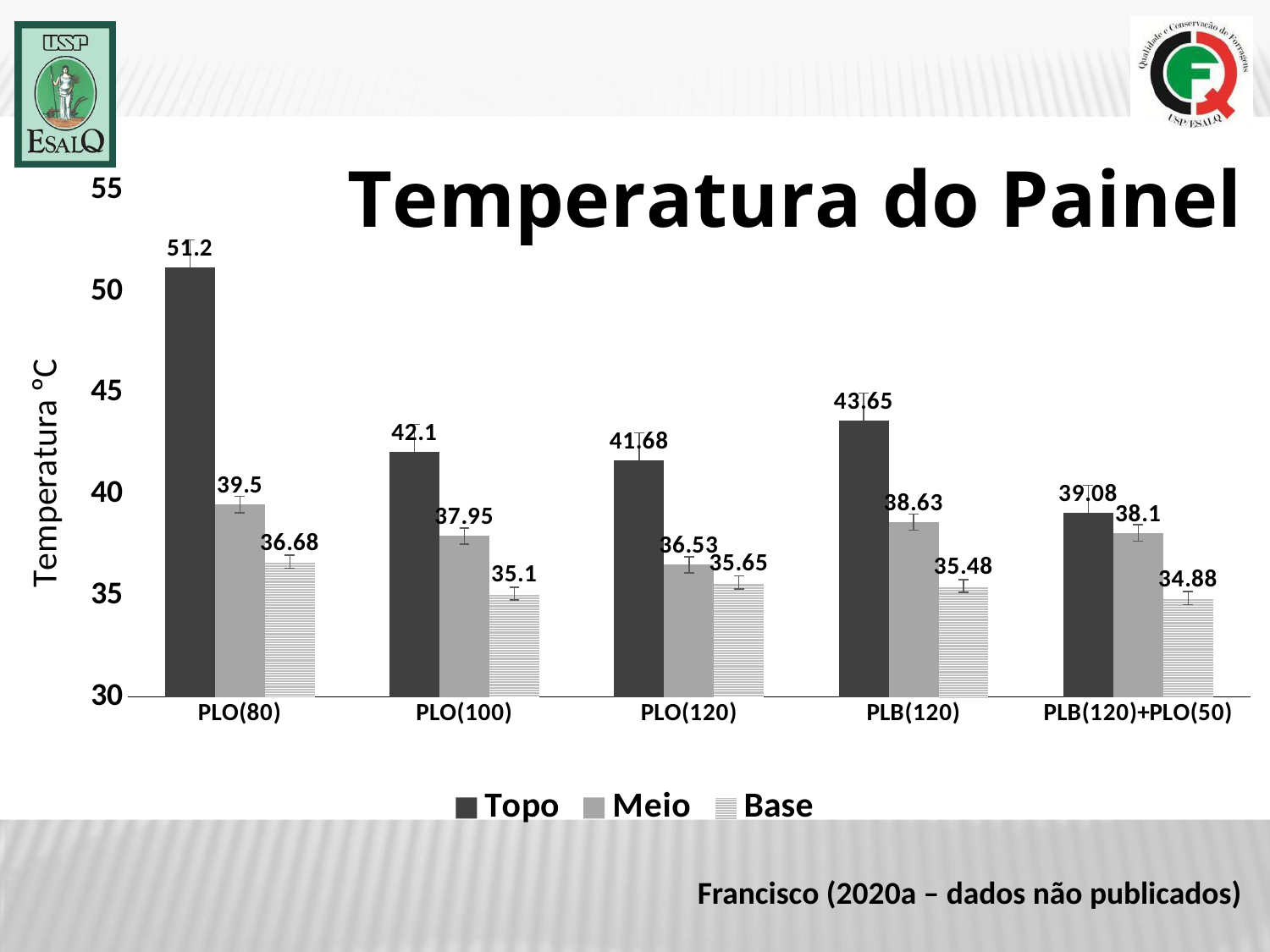
How many categories are shown on the x axis? 5 What is the Meio value for PLO(100)? 37.95 Which category has the lowest Base value? PLB(120)+PLO(50) Which category has the highest Topo value? PLO(80) What is the difference between the Topo and Base values for PLO(80)? 14.52 What is the Topo value for PLO(80)? 51.2 What is the title of the chart? Temperatura do Painel Which is larger, the Topo value for PLB(120) or the Topo value for PLO(120)? PLB(120) What is the Base value for PLB(120)+PLO(50)? 34.88 What kind of chart is shown? bar chart Is the Topo value for PLO(80) greater or less than 50? greater How many series does the legend list? 3